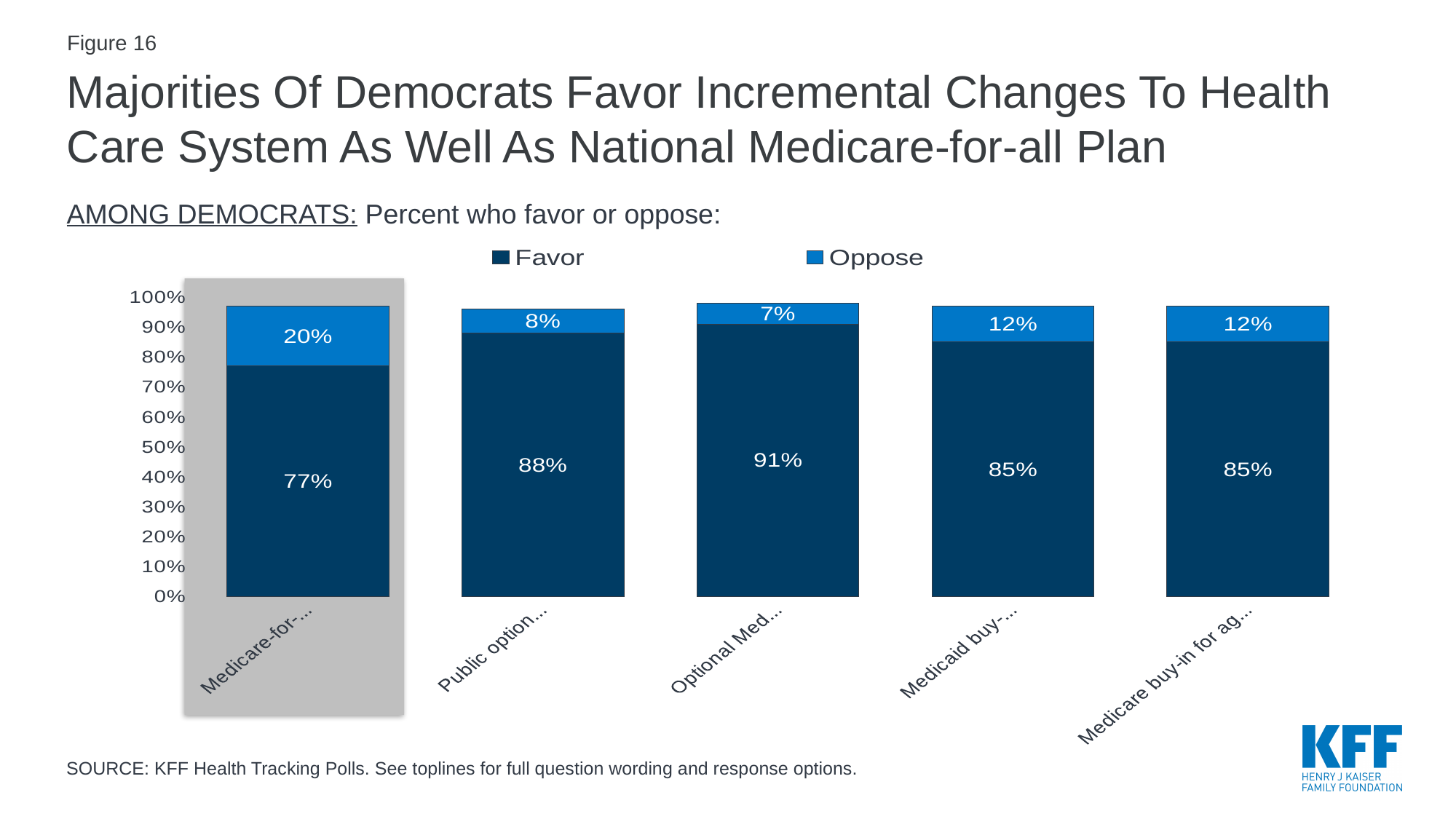
What is the Oppose value for the bar labelled "Optional Med..."? 7% What is the combined Favor and Oppose total for the bar labelled "Medicare-for-..."? 97% What type of chart is shown on the slide? Stacked bar chart What percent of Democrats oppose the first option (labelled "Medicare-for-...")? 20% What is the Favor value for the bar labelled "Public option..."? 88% What is the difference between the Favor values for "Optional Med..." and "Medicare-for-..."? 14 percentage points How many series does the legend list? 2 Which bar has the highest Favor value? Optional Med... Is the Favor value for "Public option..." larger or smaller than the Favor value for "Medicaid buy-..."? larger Which bar has the highest Oppose value? Medicare-for-... What percent of Democrats favor the first option (labelled "Medicare-for-...")? 77% Which bar has the lowest Favor value? Medicare-for-...